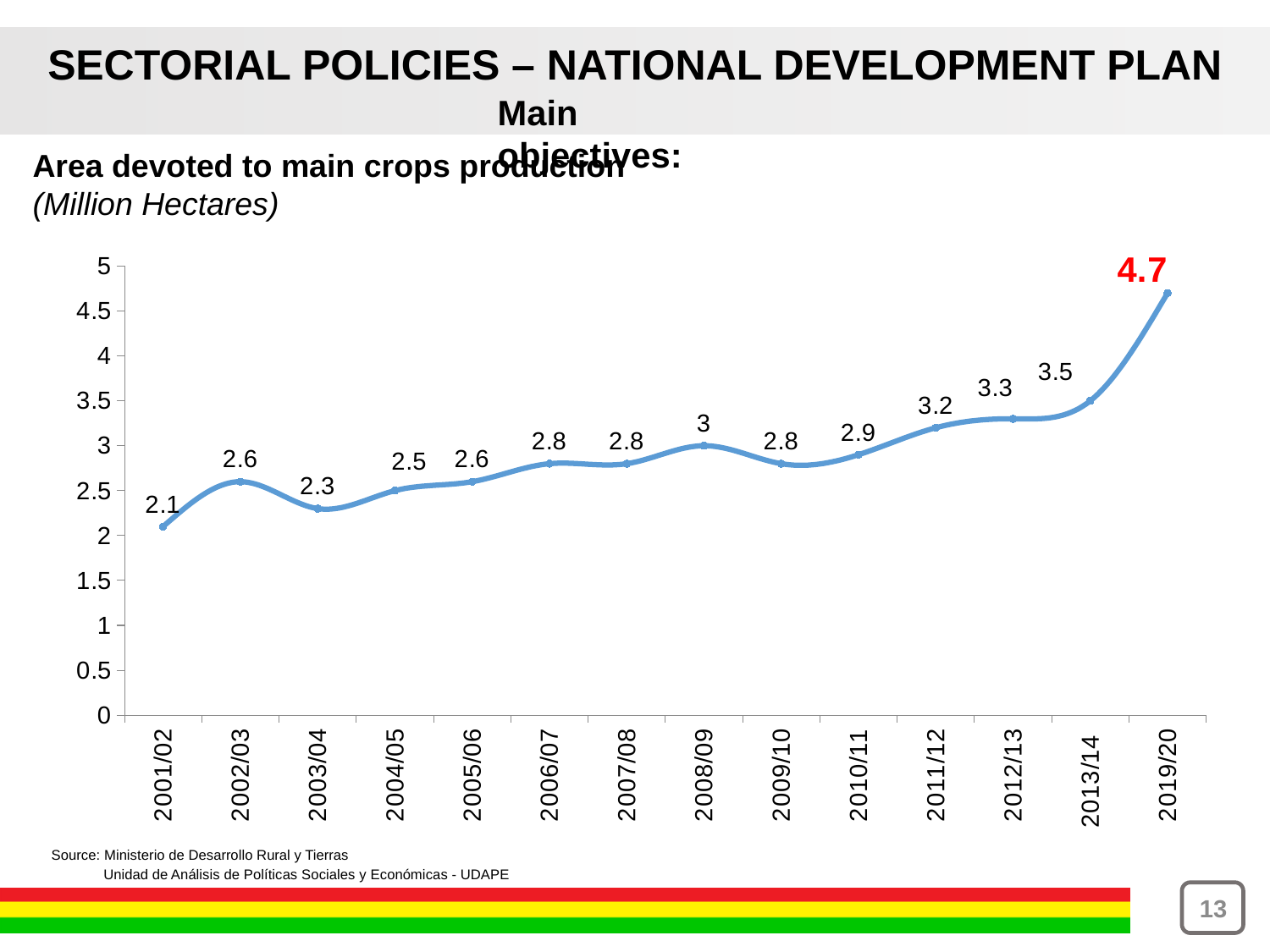
What is the value shown for 2019/20? 4.7 Do the values generally rise or fall from 2001/02 to 2019/20? Rise What kind of chart is shown on the slide? Line chart How many data points are plotted on the chart? 14 Which year has the lowest value on the chart? 2001/02 What is the area devoted to main crops production in 2001/02? 2.1 What is the difference between the values for 2019/20 and 2013/14? 1.2 What is the value shown for 2008/09? 3 Which is larger, the value for 2002/03 or the value for 2003/04? 2002/03 In what unit is the area devoted to main crops production expressed? Million Hectares What is the value shown for 2012/13? 3.3 Which year has the highest value on the chart? 2019/20